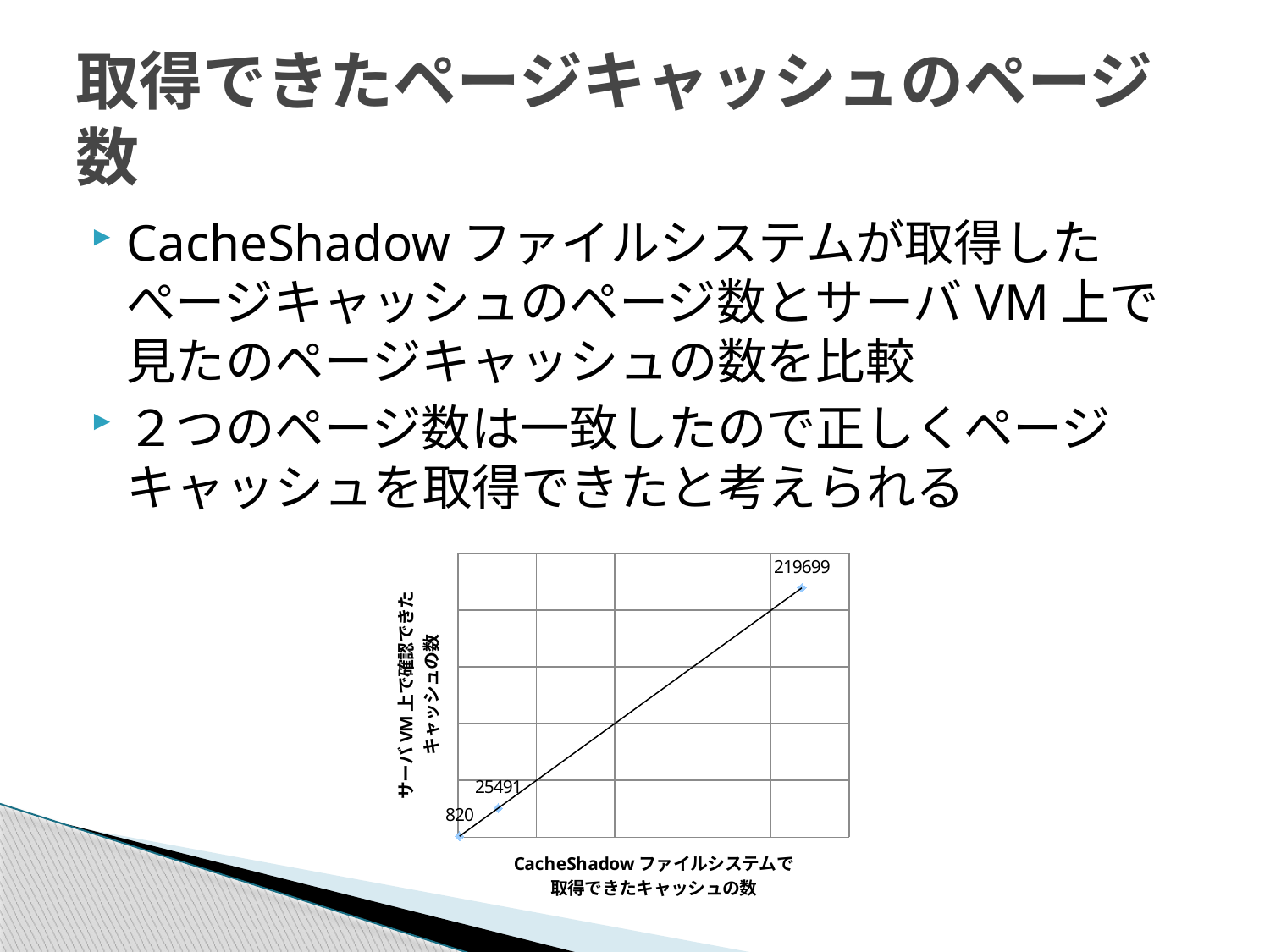
Which is larger, the value labelled 25491 or the value labelled 820? 25491 What kind of chart is shown on the slide? line chart What is the highest value labelled on the chart? 219699 What is the title of the x axis of the chart? CacheShadow ファイルシステムで取得できたキャッシュの数 What is the lowest value labelled on the chart? 820 What is the title of the y axis of the chart? サーバVM上で確認できたキャッシュの数 What is the value of the middle data point on the chart? 25491 What is the difference between the middle labelled value (25491) and the lowest labelled value (820)? 24671 What is the difference between the highest labelled value (219699) and the middle labelled value (25491)? 194208 Do the plotted values rise or fall as you move from left to right along the x axis? rise How many data points are plotted on the chart? 3